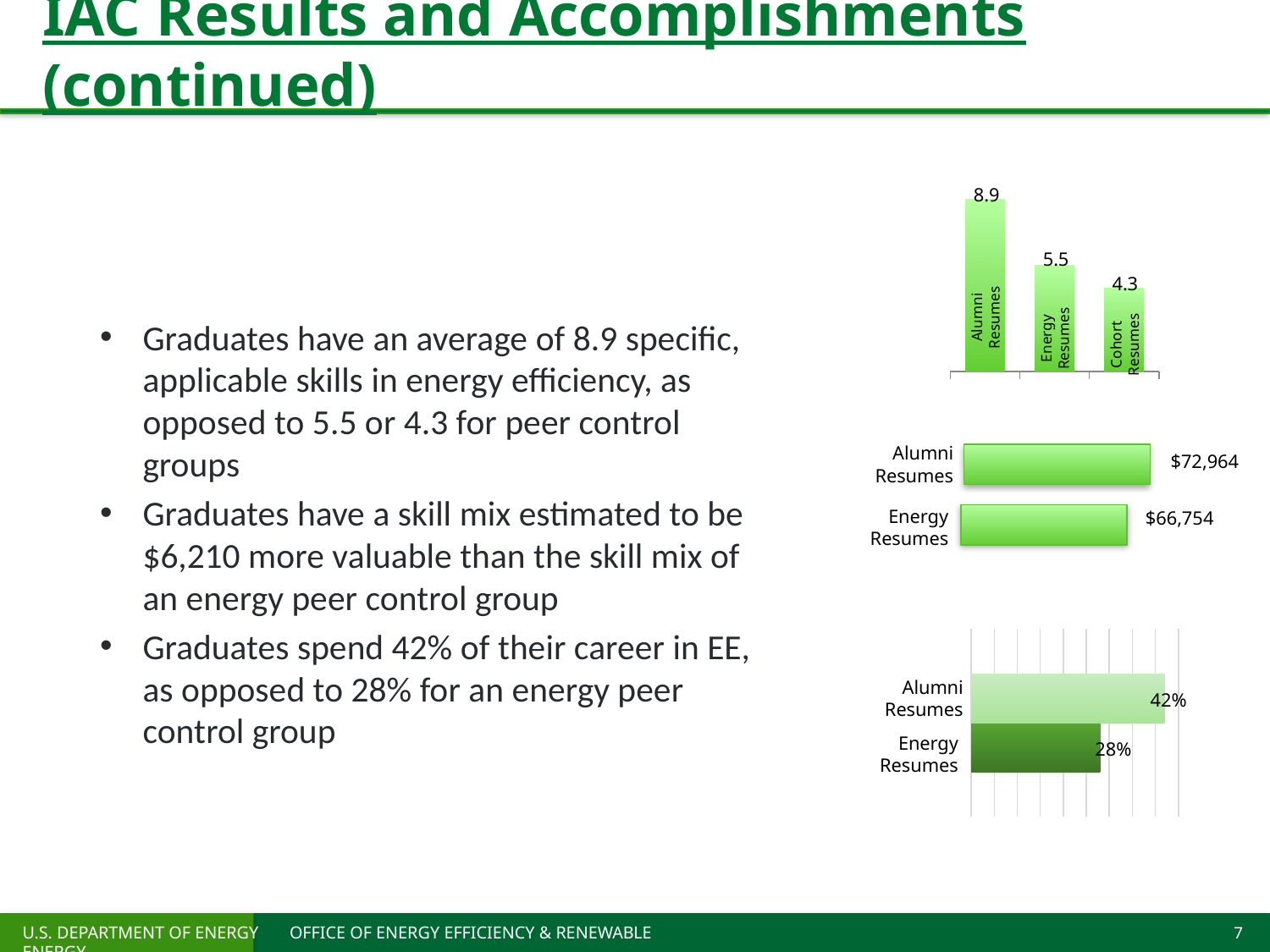
In the middle chart on the right, what is the value for Alumni Resumes? $72,964 In the top chart on the right, how many bars are plotted? 3 In the top chart on the right, what is the value for Alumni Resumes? 8.9 In the bottom chart on the right, what is the value for Energy Resumes? 28% In the middle chart on the right, which category has the higher value, Alumni Resumes or Energy Resumes? Alumni Resumes In the top chart on the right, which category has the lowest value? Cohort Resumes In the middle chart on the right, what is the difference between the Alumni Resumes and Energy Resumes values? $6,210 In the bottom chart on the right, what is the difference between the Alumni Resumes and Energy Resumes values? 14% In the middle chart on the right, what is the value for Energy Resumes? $66,754 In the top chart on the right, what is the value for Cohort Resumes? 4.3 What kind of chart is the bottom chart on the right? Bar chart In the top chart on the right, what is the difference between Alumni Resumes and Energy Resumes? 3.4